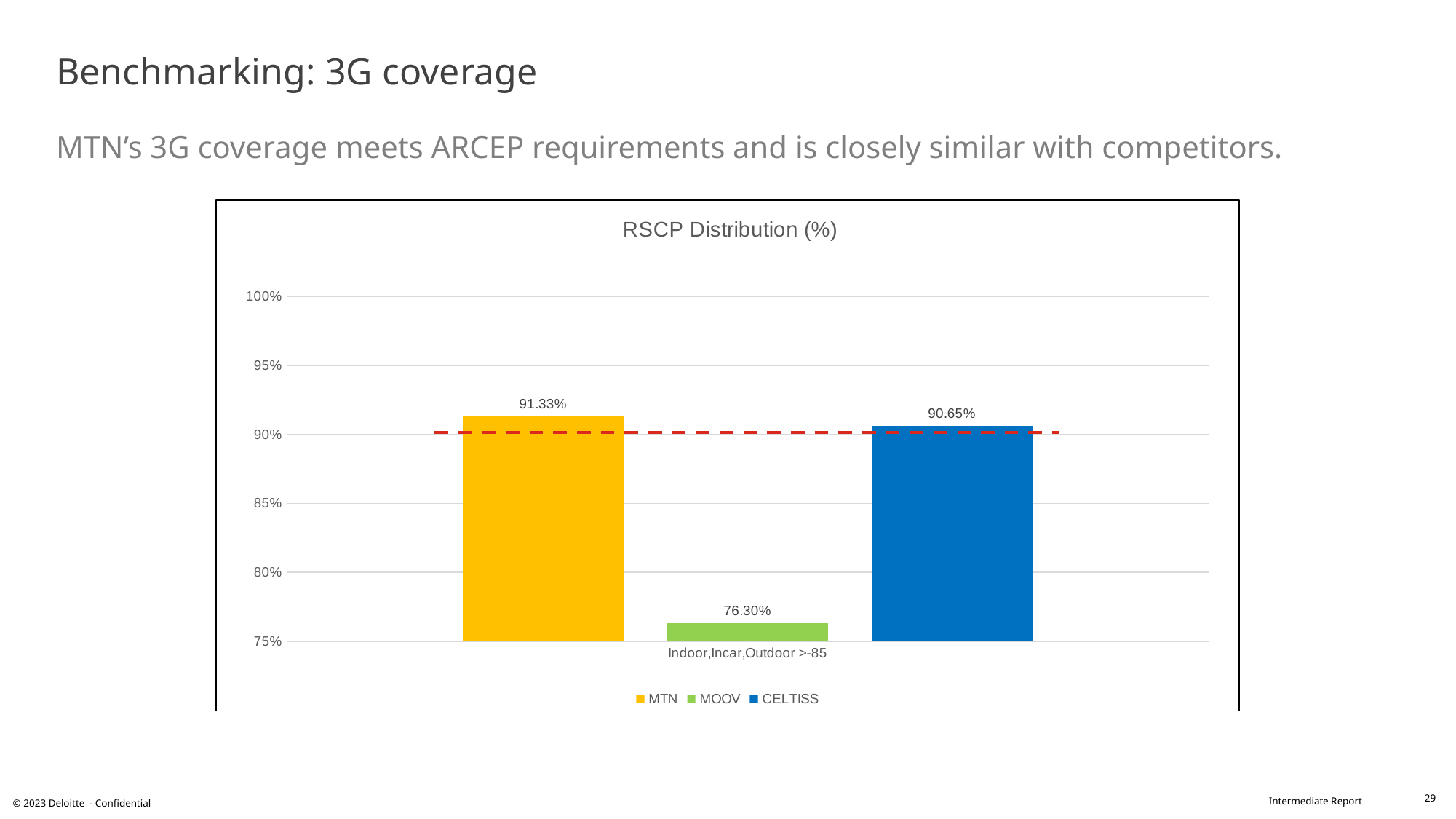
What is the difference between the MTN and CELTISS values in the RSCP Distribution (%) chart? 0.68% Which operator has the lowest value in the RSCP Distribution (%) chart? MOOV What is the value for CELTISS in the RSCP Distribution (%) chart? 90.65% Is the value for MOOV greater or less than 80% in the RSCP Distribution (%) chart? less How many series does the legend of the RSCP Distribution (%) chart list? 3 What kind of chart is the RSCP Distribution (%) chart? bar chart Which is larger in the RSCP Distribution (%) chart, the value for MOOV or the value for CELTISS? CELTISS What is the title of the chart on the slide? RSCP Distribution (%) What is the value for MOOV in the RSCP Distribution (%) chart? 76.30% What is the value for MTN in the RSCP Distribution (%) chart? 91.33% Which operator has the highest value in the RSCP Distribution (%) chart? MTN What is the difference between the MTN and MOOV values in the RSCP Distribution (%) chart? 15.03%